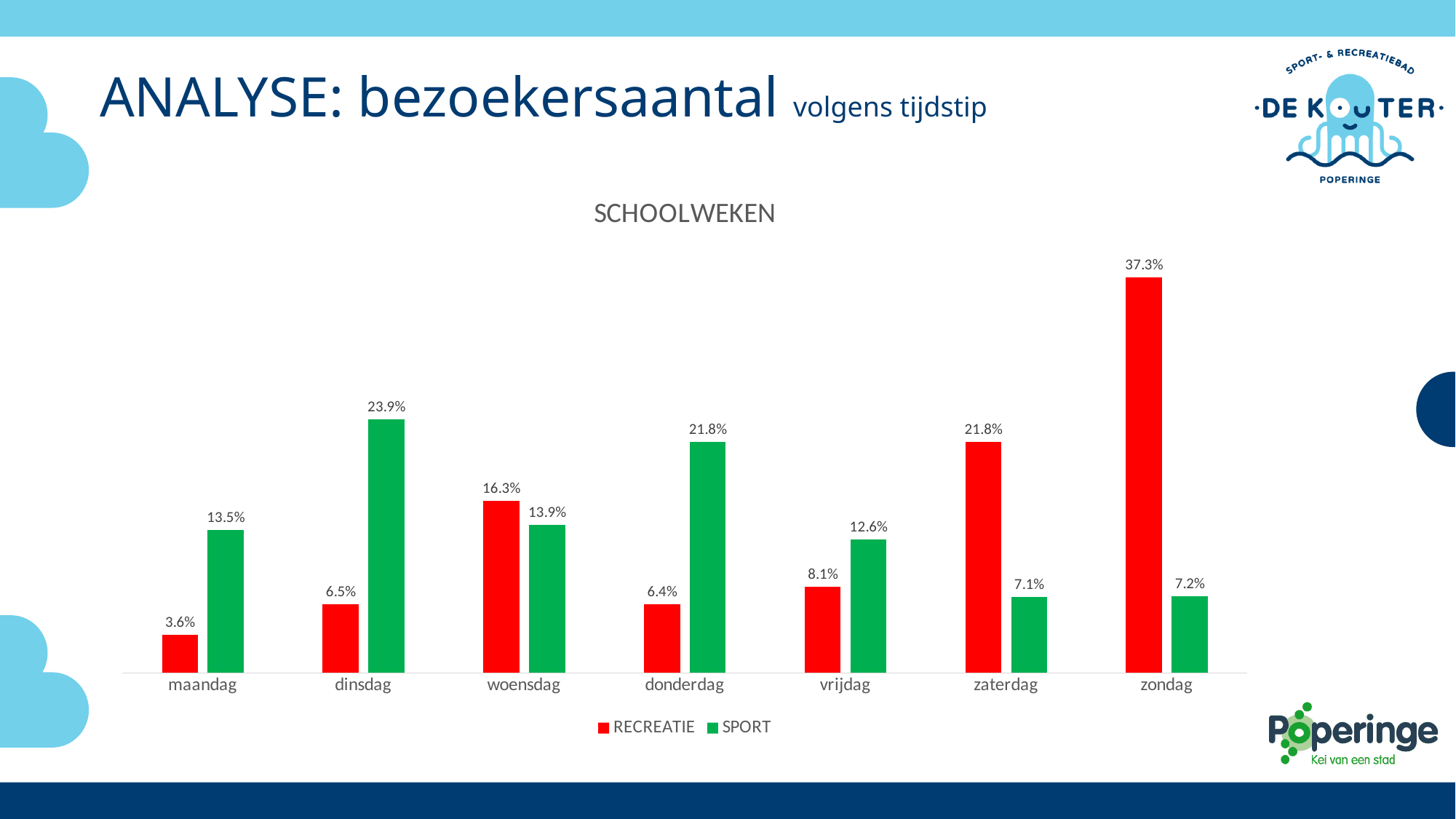
How many days are shown on the x axis? 7 What is the SPORT value for dinsdag? 23.9% How many series does the legend list? 2 What is the difference between the SPORT and RECREATIE values for donderdag? 15.4% Which day has the lowest RECREATIE value? maandag Which is larger for woensdag, RECREATIE or SPORT? RECREATIE Which colour represents the SPORT series? green What is the RECREATIE value for zondag? 37.3% What kind of chart is shown? bar chart What is the RECREATIE value for maandag? 3.6% Which day has the highest SPORT value? dinsdag What is the title of the chart? SCHOOLWEKEN